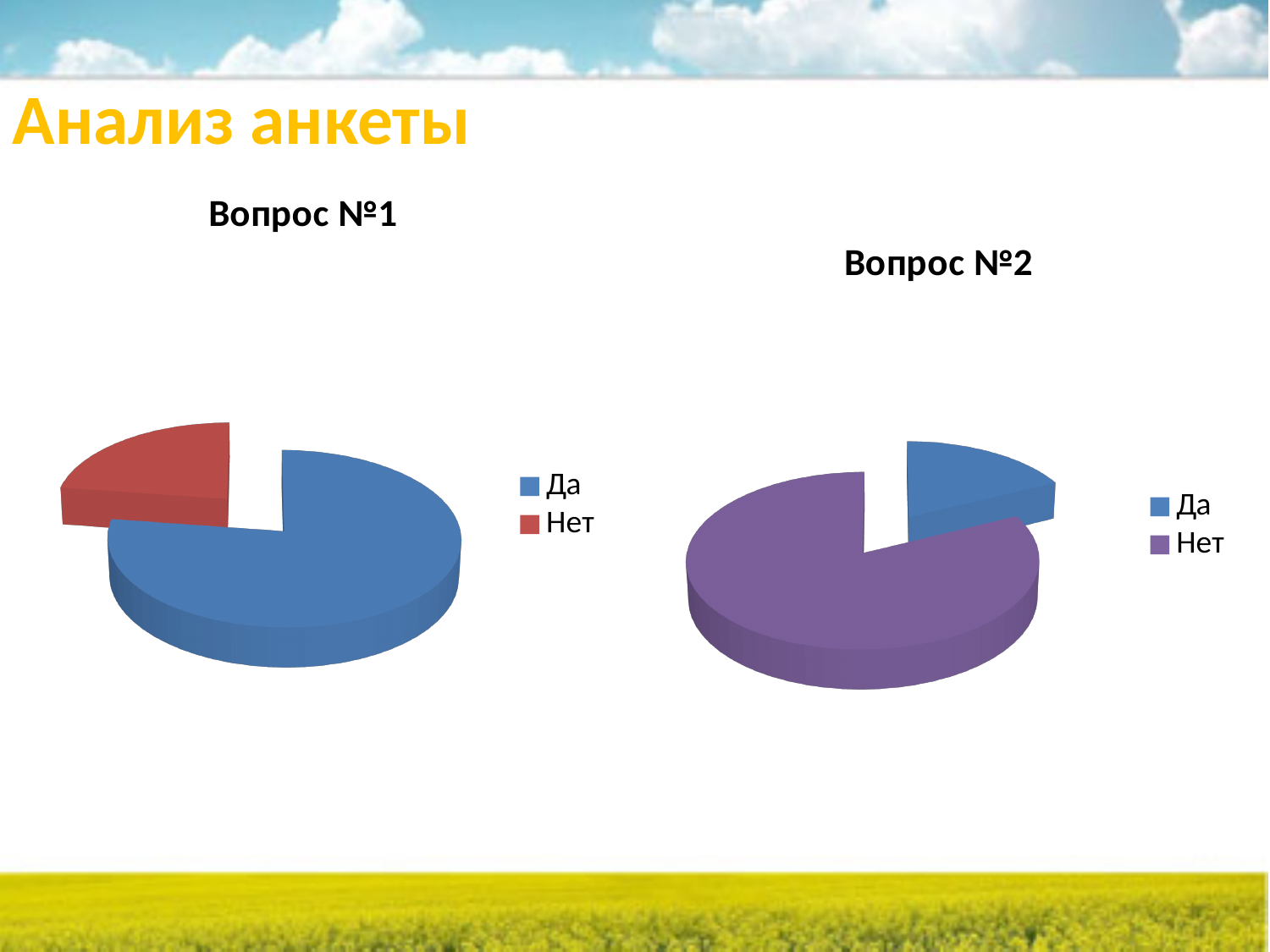
In the "Вопрос №2" chart, what colour is the Нет slice? purple How many slices does the "Вопрос №1" chart have? 2 How many slices does the "Вопрос №2" chart have? 2 In the "Вопрос №2" chart, which slice is larger, Да or Нет? Нет In the "Вопрос №2" chart, which category has the smallest slice? Да What are the legend entries of the "Вопрос №2" chart? Да, Нет In the "Вопрос №1" chart, which slice is larger, Да or Нет? Да In the "Вопрос №2" chart, which category has the largest slice? Нет In the "Вопрос №1" chart, which category has the largest slice? Да In the "Вопрос №1" chart, which category has the smallest slice? Нет What kind of chart is the "Вопрос №2" chart? pie chart What kind of chart is the "Вопрос №1" chart? pie chart